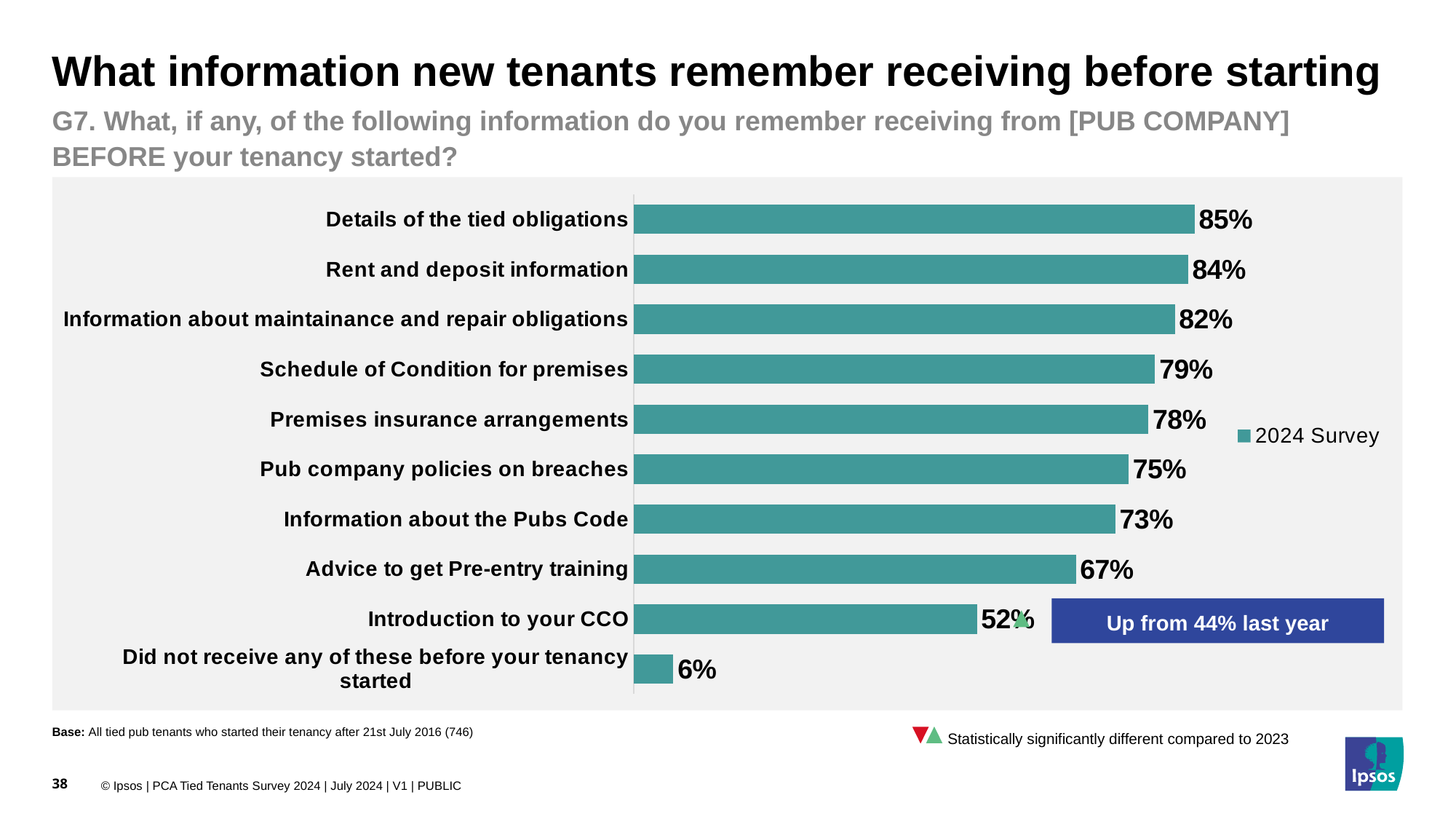
According to the callout, what was the value for 'Introduction to your CCO' last year? 44% What percentage did not receive any of these before their tenancy started? 6% What kind of chart is shown on the slide? Bar chart Which category has the lowest value? Did not receive any of these before your tenancy started What percentage of new tenants remember receiving details of the tied obligations? 85% Which category has the highest value? Details of the tied obligations What is the value for 'Introduction to your CCO'? 52% How many categories are shown in the chart? 10 Which is larger: 'Schedule of Condition for premises' or 'Pub company policies on breaches'? Schedule of Condition for premises What does the legend entry say? 2024 Survey What is the difference between 'Rent and deposit information' and 'Advice to get Pre-entry training'? 17 percentage points How many series does the legend list? 1